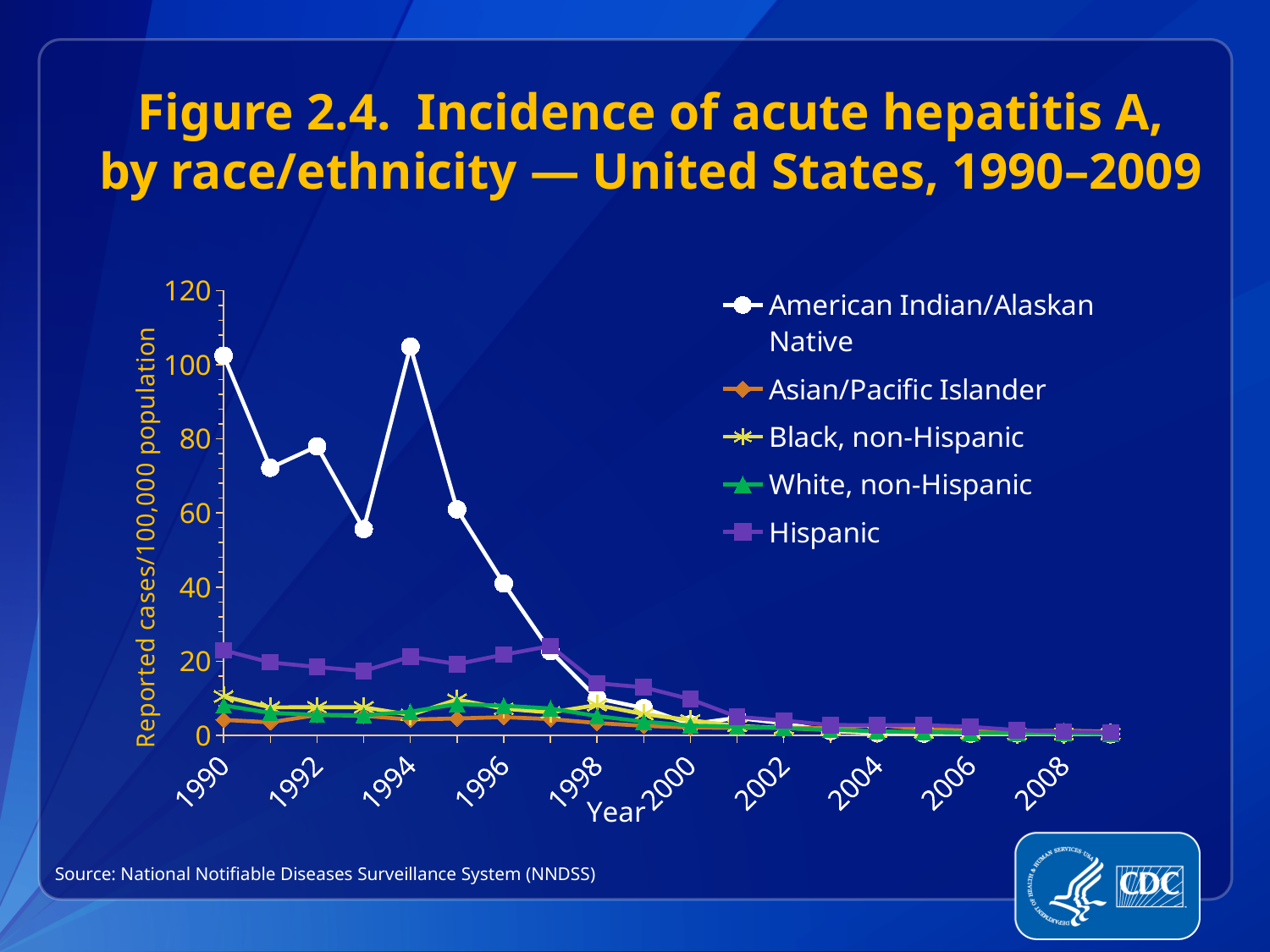
What is the label on the y axis? Reported cases/100,000 population How many years (data points per series) are plotted along the x axis? 20 Is the value for American Indian/Alaskan Native in 1990 greater or less than 80? greater How many series does the legend list? 5 Which race/ethnicity group has the highest incidence in 1990? American Indian/Alaskan Native Is the value for Hispanic in 1990 greater or less than 40? less What kind of chart is shown on the slide? line chart Which series is plotted with square markers? Hispanic Is the value for American Indian/Alaskan Native in 1995 greater or less than 40? greater For American Indian/Alaskan Native, which year has the larger value, 1993 or 1994? 1994 Overall, does the American Indian/Alaskan Native incidence rise or fall from 1990 to 2009? fall